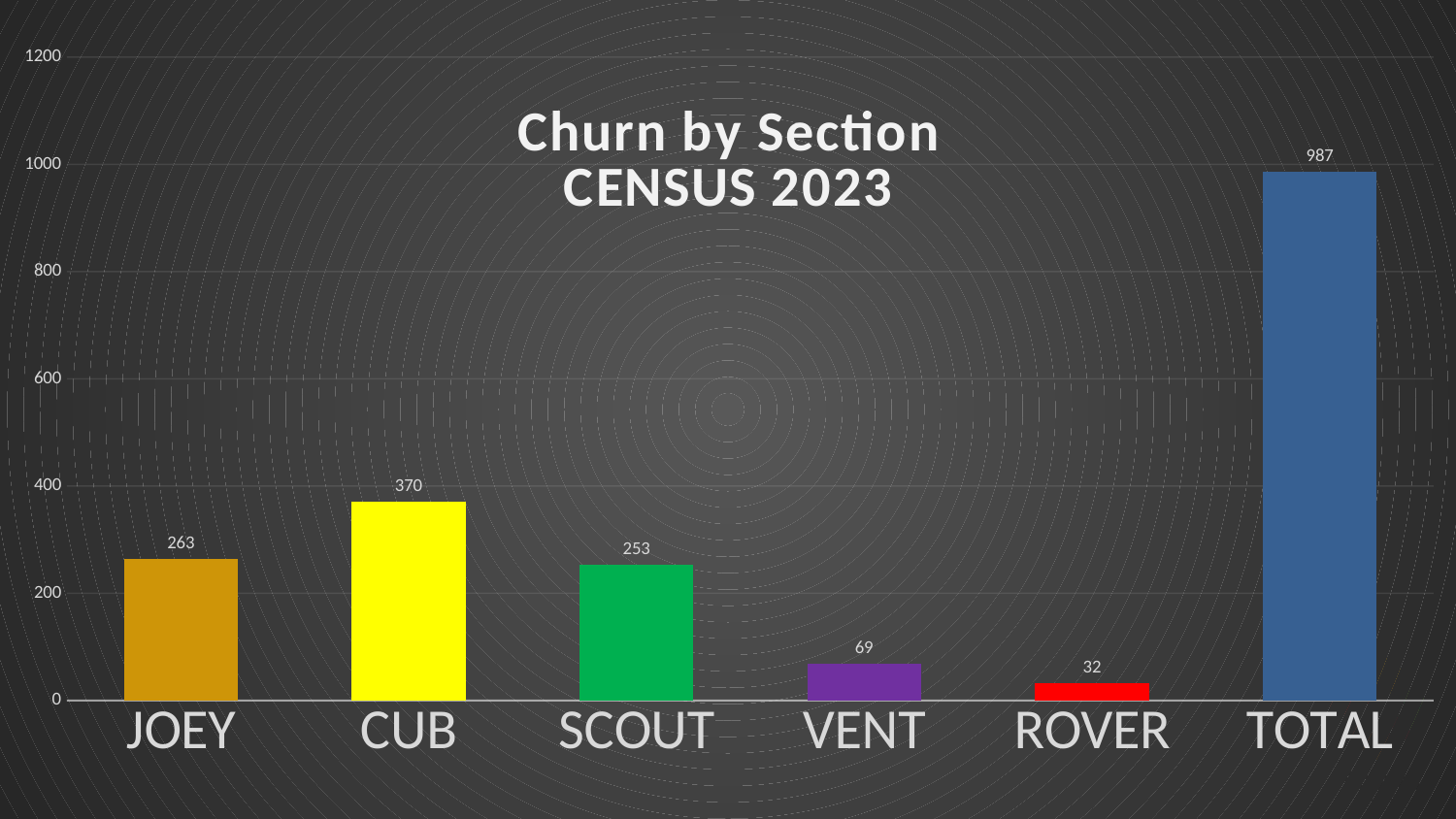
What is the difference between the values for CUB and JOEY? 107 What is the value for ROVER? 32 What kind of chart is this? bar chart What is the value for CUB? 370 Is the value for CUB greater or less than 400? less What is the value for TOTAL? 987 Which category has the highest value? TOTAL Which category has the lowest value? ROVER Which is larger, the value for JOEY or the value for SCOUT? JOEY What is the difference between the values for VENT and ROVER? 37 How many categories are shown on the x axis? 6 What is the title of the chart? Churn by Section CENSUS 2023